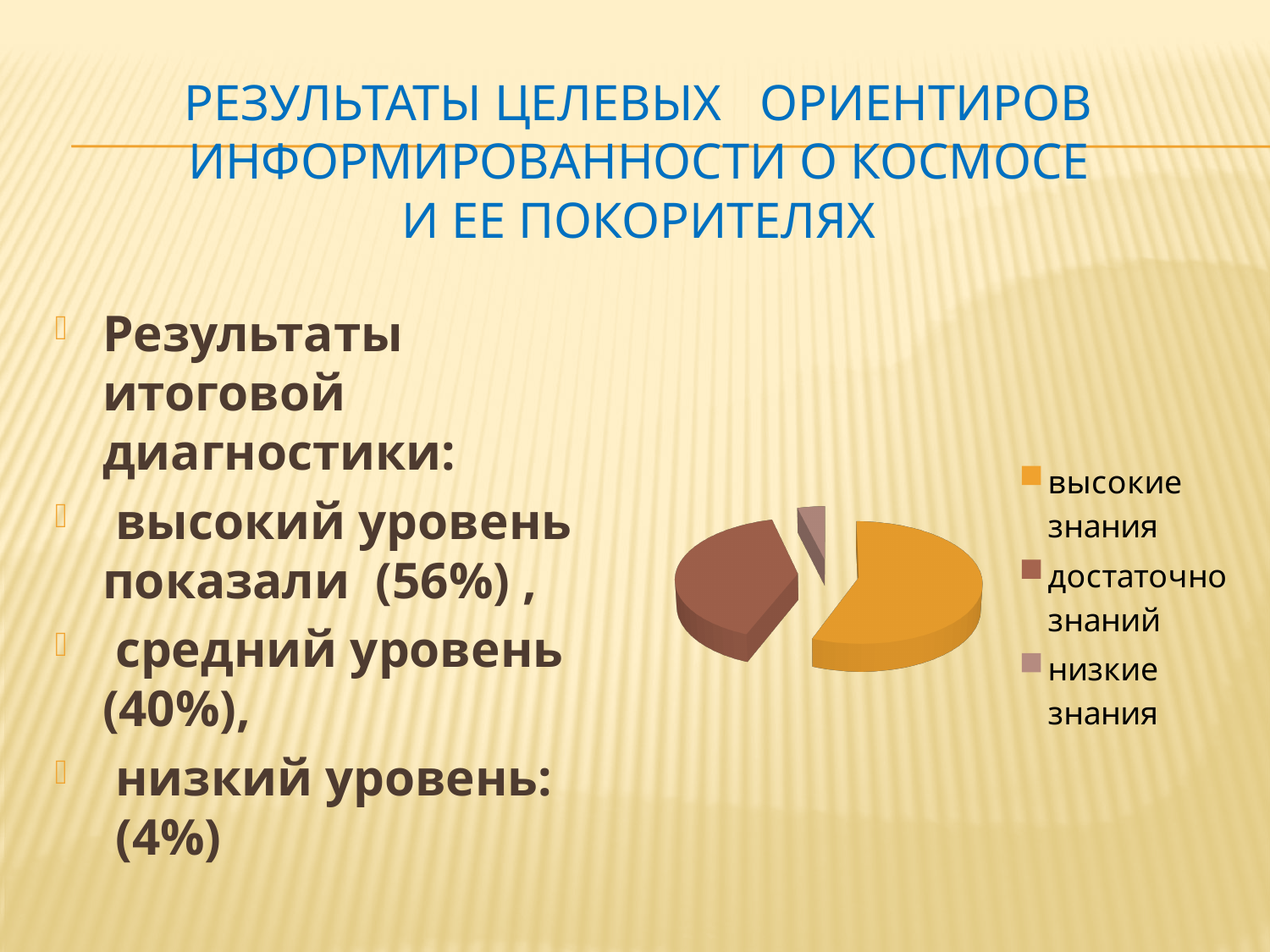
Which category has the smallest slice in the pie chart? низкие знания Which slice is larger in the pie chart: достаточно знаний or низкие знания? достаточно знаний Which slice is larger in the pie chart: высокие знания or достаточно знаний? высокие знания What kind of chart is shown on the slide? pie chart What colour is the slice for высокие знания in the pie chart? orange How many entries does the legend of the pie chart list? 3 How many slices does the pie chart have? 3 Which category has the largest slice in the pie chart? высокие знания Which legend entry is listed first in the pie chart's legend? высокие знания